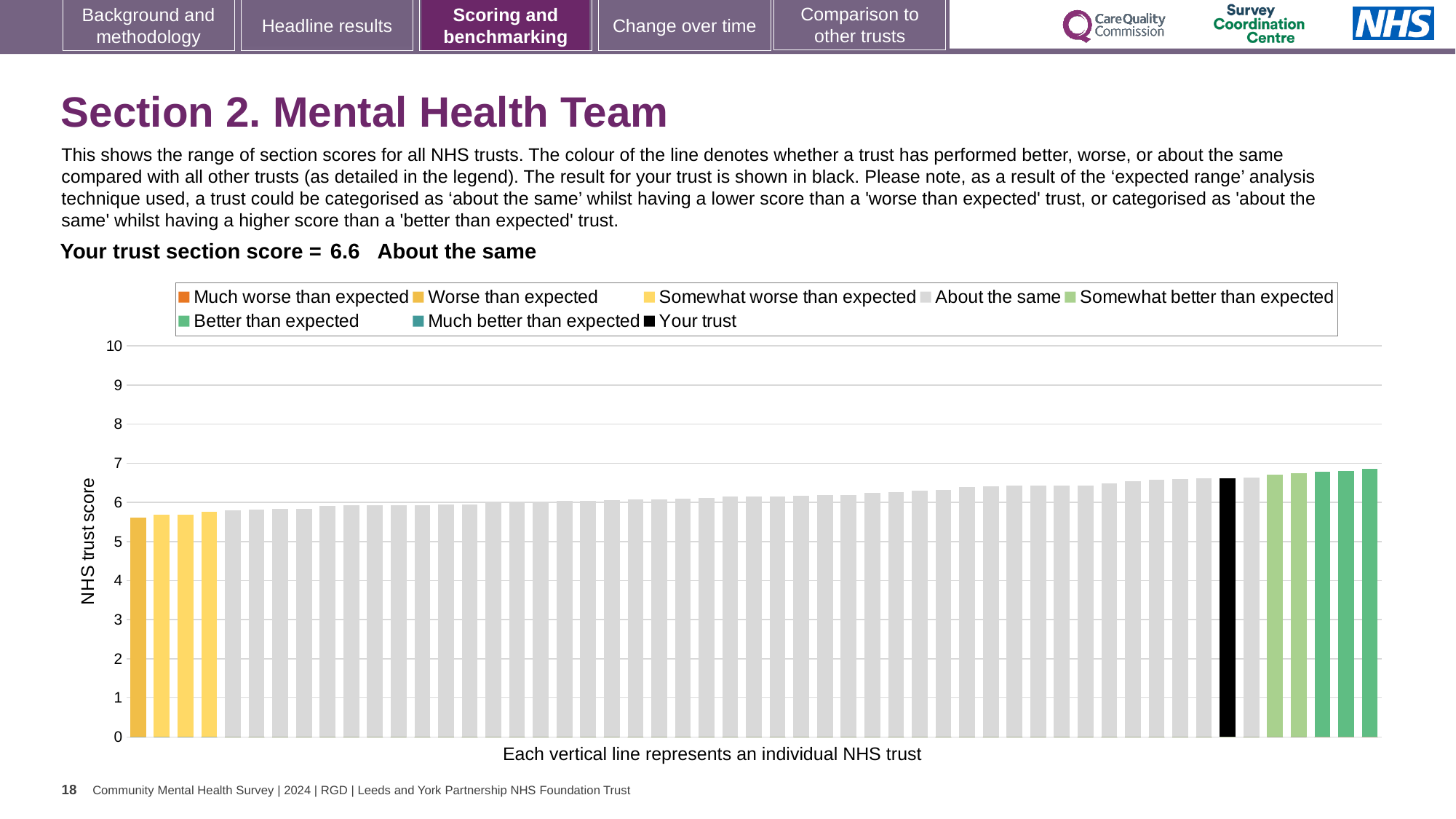
Do the bar values rise or fall from left to right along the x axis? rise How many bars are coloured as 'Better than expected'? 3 What kind of chart is shown on the slide? bar chart Which legend category does the tallest bar belong to? Better than expected What is the label on the y axis of the chart? NHS trust score Is the value of the leftmost bar greater or less than 6? less Which is taller: the black 'Your trust' bar or the leftmost bar? the black 'Your trust' bar What is the trust's section score shown above the chart? 6.6 Is the value of the tallest bar greater or less than 7? less How many entries does the chart legend list? 8 Which legend category does the shortest bar belong to? Worse than expected Is the value of the black 'Your trust' bar greater or less than 6? greater